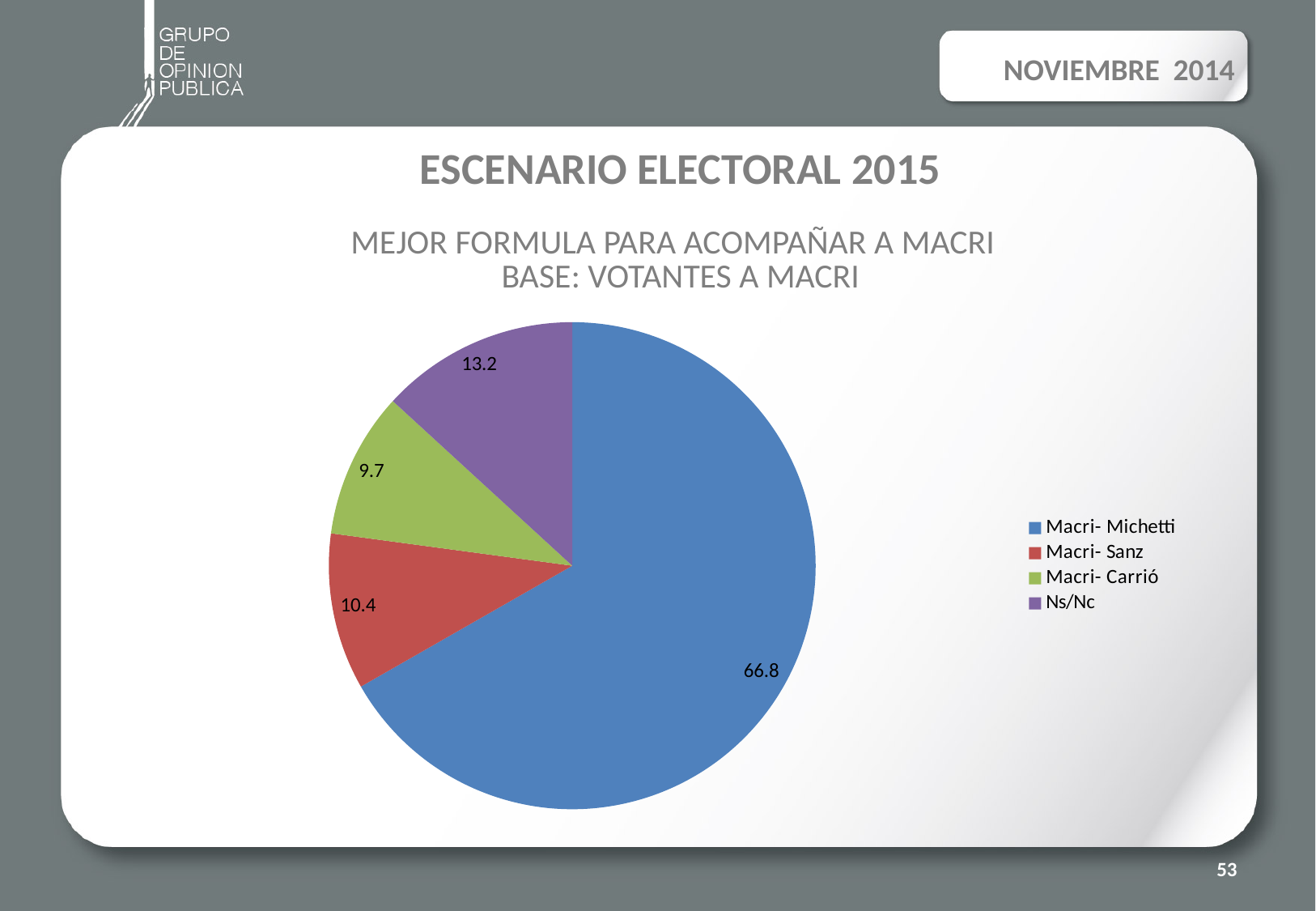
Which category has the smallest slice? Macri- Carrió What kind of chart is shown on the slide? pie chart Which category has the largest slice? Macri- Michetti What is the value for Macri- Sanz? 10.4 What colour is the Macri- Carrió slice? green Which is larger, the value for Ns/Nc or the value for Macri- Sanz? Ns/Nc What is the value for Macri- Michetti? 66.8 How many entries does the legend list? 4 What is the value for Ns/Nc? 13.2 What is the difference between the values for Macri- Michetti and Ns/Nc? 53.6 How many slices does the pie chart have? 4 What is the value for Macri- Carrió? 9.7